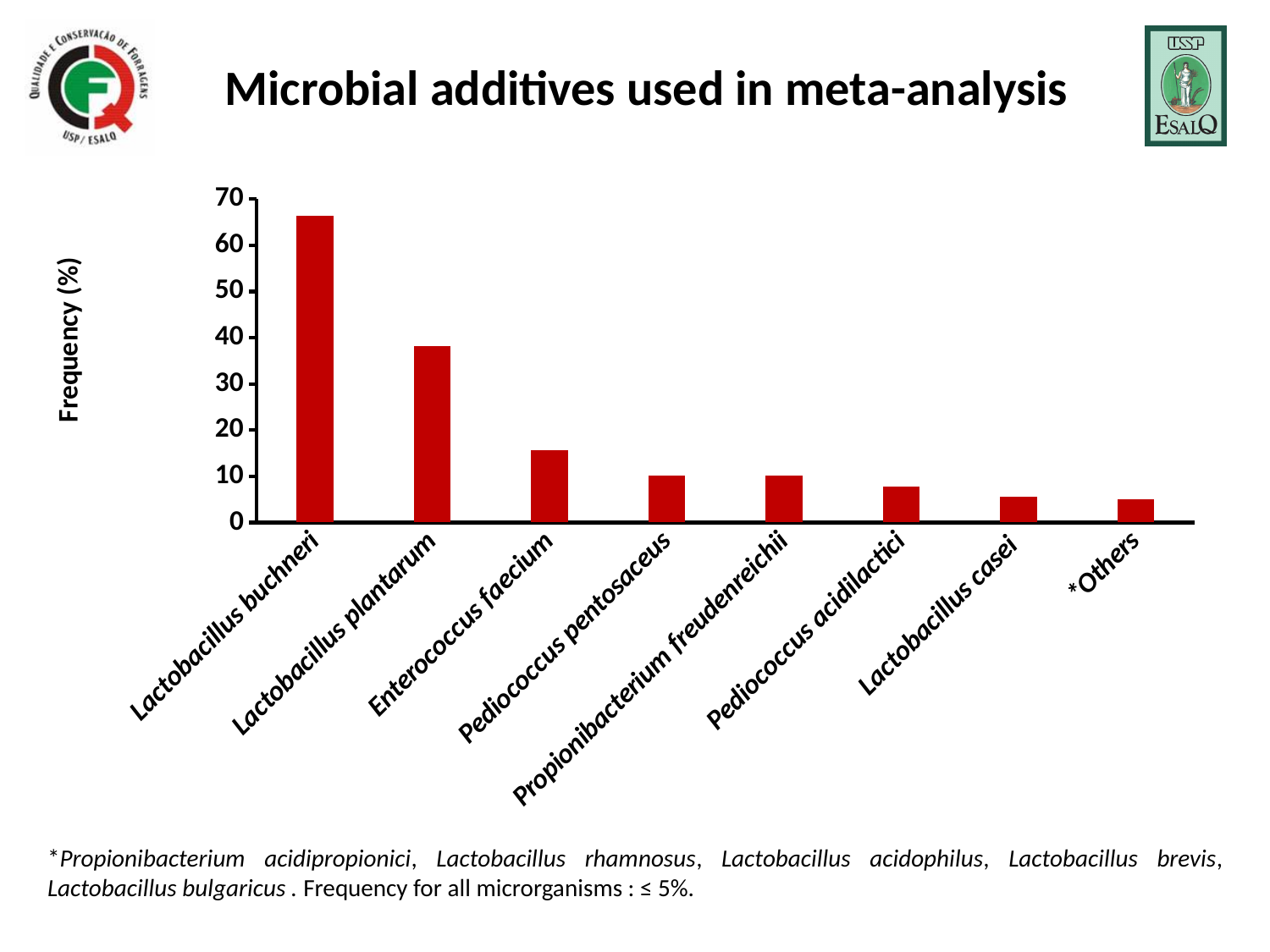
How many categories (microbial additives) are plotted on the x axis? 8 Which has a higher frequency, Enterococcus faecium or Pediococcus pentosaceus? Enterococcus faecium Is the frequency for Enterococcus faecium greater or less than 10? greater Which microbial additive has the highest frequency? Lactobacillus buchneri Is the frequency for Lactobacillus plantarum greater or less than 40? less What is the label of the y axis? Frequency (%) Is the frequency for Lactobacillus buchneri greater or less than 60? greater What kind of chart is shown on the slide? bar chart Do the bar values rise or fall moving from left to right along the x axis? fall Which has a higher frequency, Lactobacillus buchneri or Lactobacillus plantarum? Lactobacillus buchneri What is the title of the chart? Microbial additives used in meta-analysis